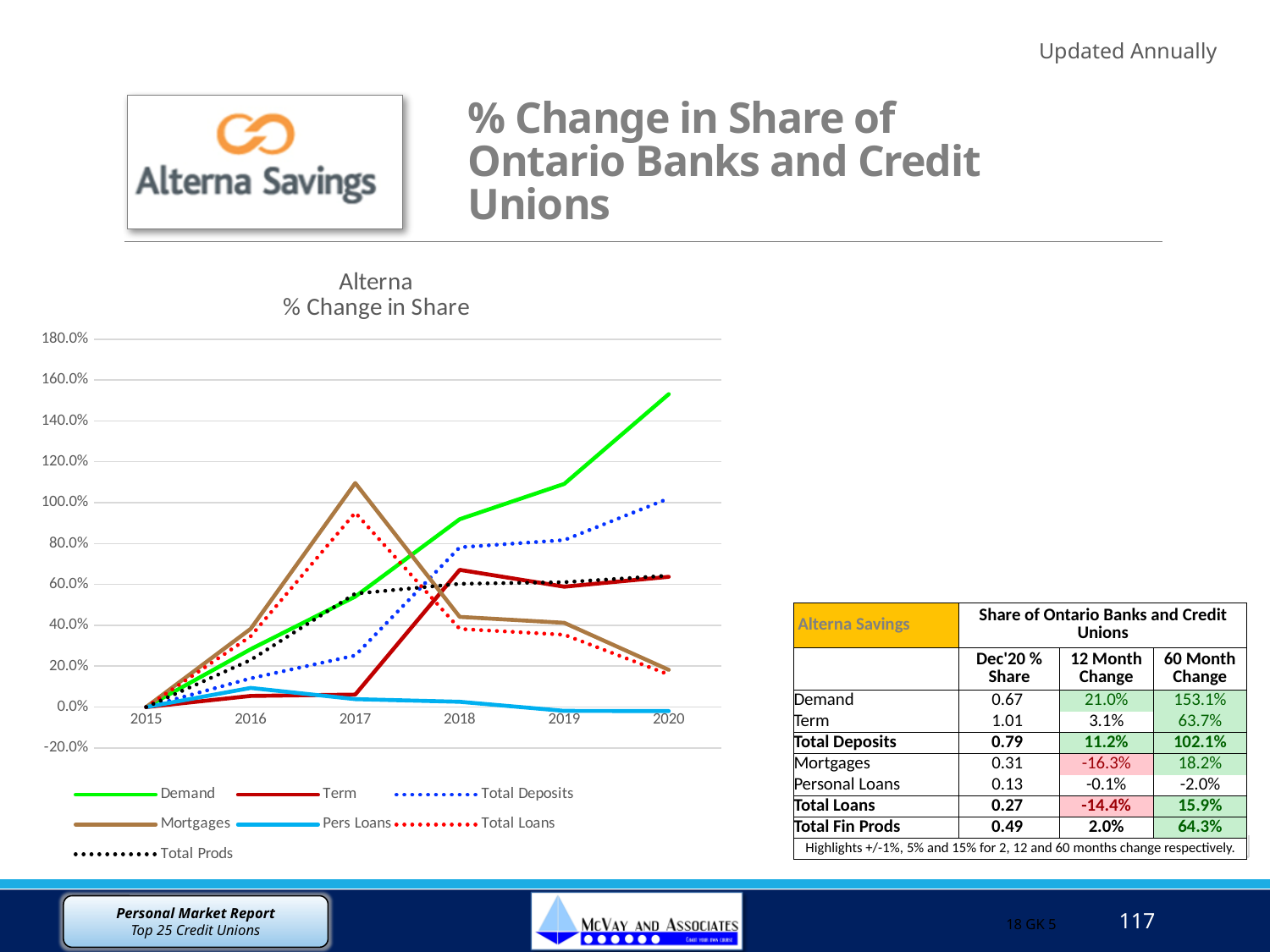
Does the Demand series rise or fall from 2015 to 2020? rise Is the value for Total Loans in 2017 greater or less than 80.0%? greater Is the value for Mortgages in 2017 greater or less than 100.0%? greater In 2020, which is larger: the value for Demand or the value for Mortgages? Demand Is the value for Demand in 2020 greater or less than 140.0%? greater Which series has the highest value in 2020? Demand How many years are shown along the x axis of the chart? 6 Which series has the highest value in 2017? Mortgages Which series has the lowest value in 2020? Pers Loans What kind of chart is shown on the slide? line chart How many series does the chart legend list? 7